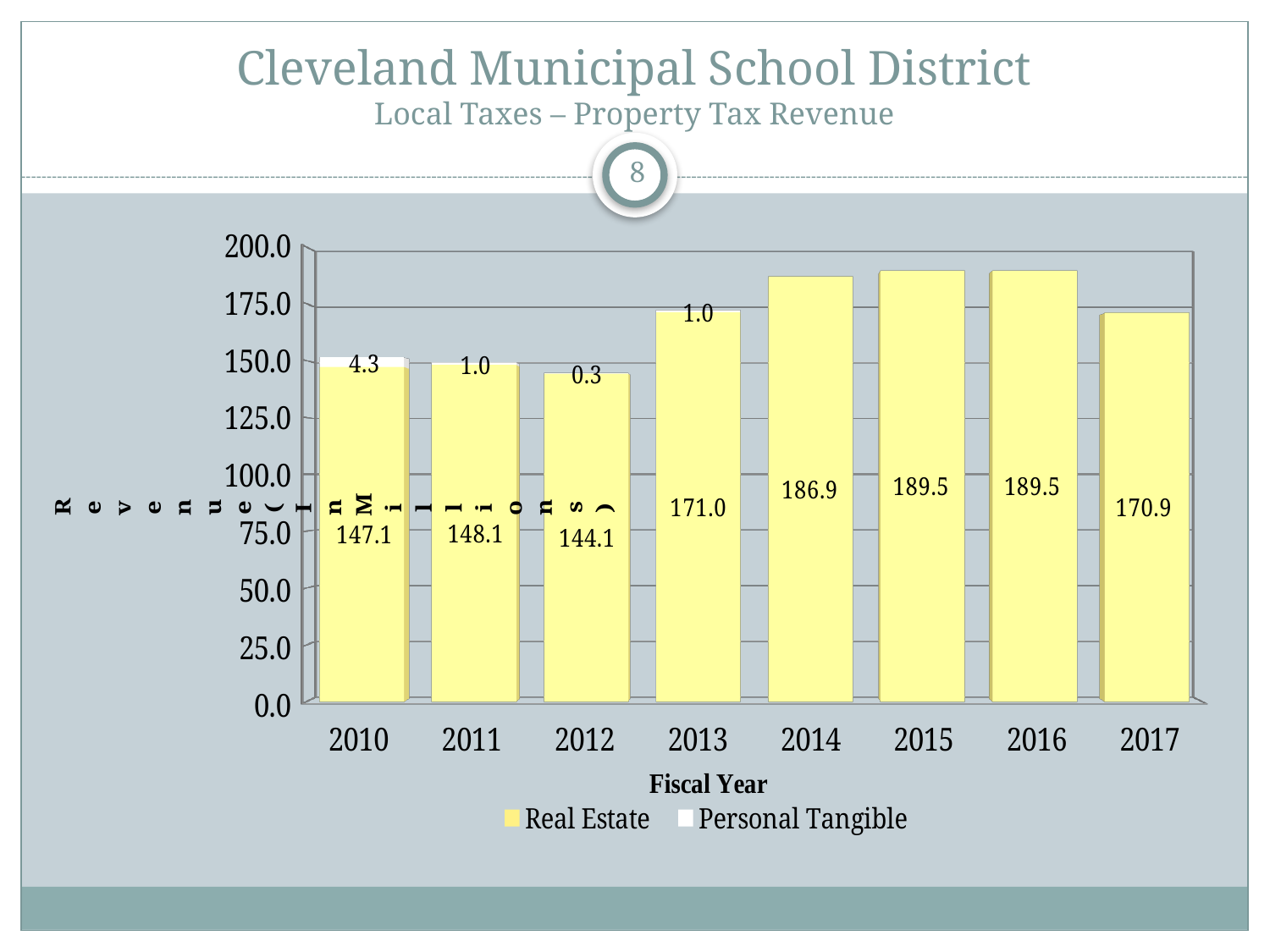
What is the Real Estate value for 2014? 186.9 What is the label of the x axis? Fiscal Year What is the difference between the Real Estate values for 2015 and 2017? 18.6 Which is larger, the Real Estate value for 2011 or for 2013? 2013 What is the Personal Tangible value for 2010? 4.3 How many series does the legend list? 2 Which fiscal year has the lowest Real Estate value? 2012 How many fiscal years are shown on the x axis? 8 What kind of chart is shown on the slide? Stacked bar chart What is the total of the stacked bar for 2010? 151.4 What is the Real Estate value for 2017? 170.9 Which fiscal year has the highest Personal Tangible value? 2010